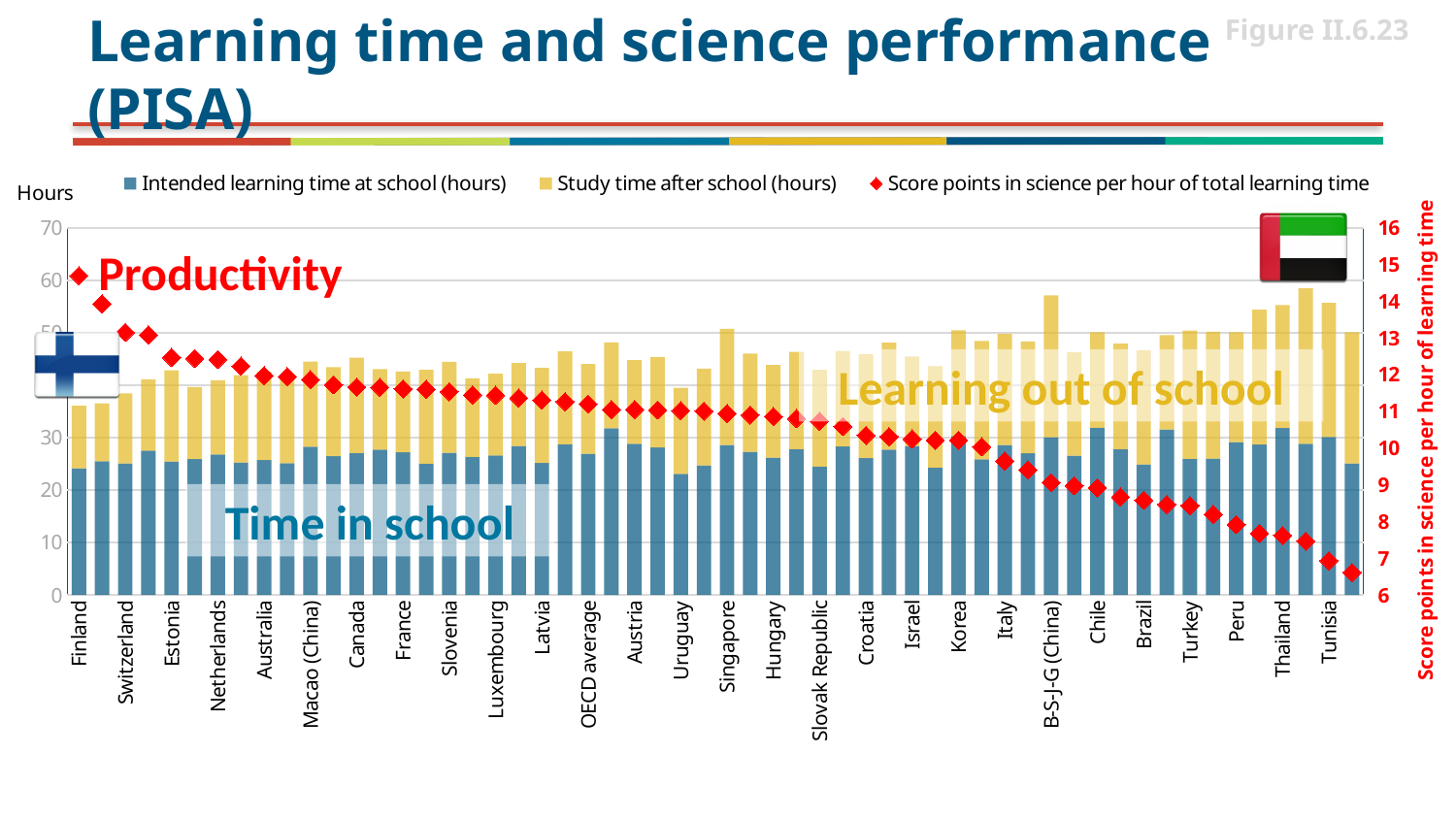
Which has the higher score points in science per hour of total learning time, Finland or Tunisia? Finland Is the intended learning time at school for Finland greater or less than 30 hours? less Which has the larger total learning time, Finland or Korea? Korea Do the red diamonds for score points in science per hour of total learning time rise or fall from left to right across the countries? fall What kind of chart is used to show the learning time hours on this slide? bar chart Is the total learning time (school plus after school) for Finland greater or less than 40 hours? less What is the label of the left vertical axis? Hours Is the score points in science per hour of total learning time for Finland greater or less than 14? greater How many series does the legend list? 3 What is the figure number shown in the top right corner of the slide? Figure II.6.23